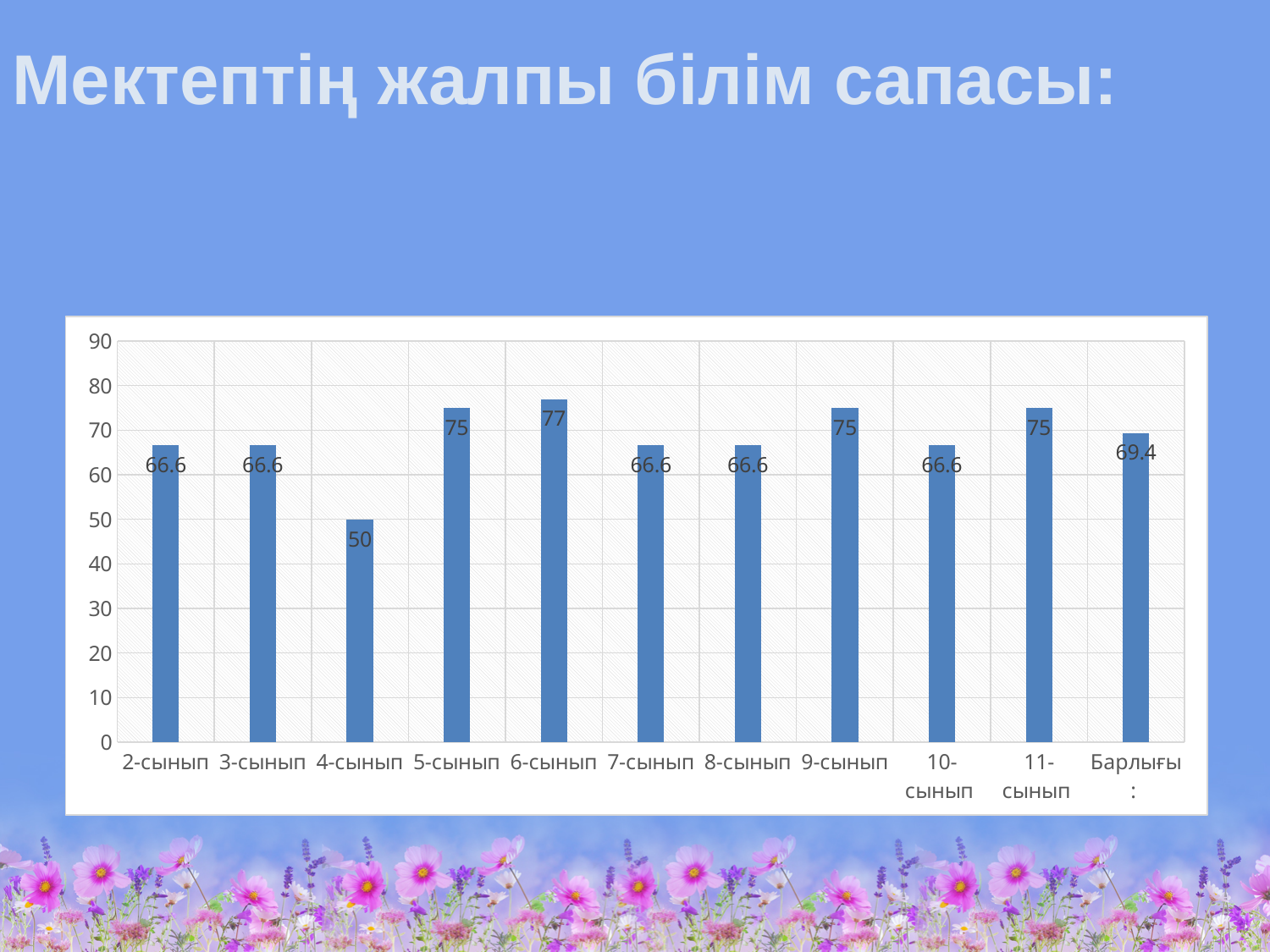
Which is larger, the value for 5-сынып or the value for 7-сынып? 5-сынып What is the value for Барлығы:? 69.4 Which category has the lowest value? 4-сынып What is the value for 9-сынып? 75 Is the value for 11-сынып greater or less than 70? greater What is the title of the slide above the chart? Мектептің жалпы білім сапасы: What is the value for 6-сынып? 77 What is the difference between the values for 6-сынып and 4-сынып? 27 What is the value for 4-сынып? 50 Which category has the highest value? 6-сынып How many categories are shown on the x axis? 11 What kind of chart is shown on the slide? bar chart